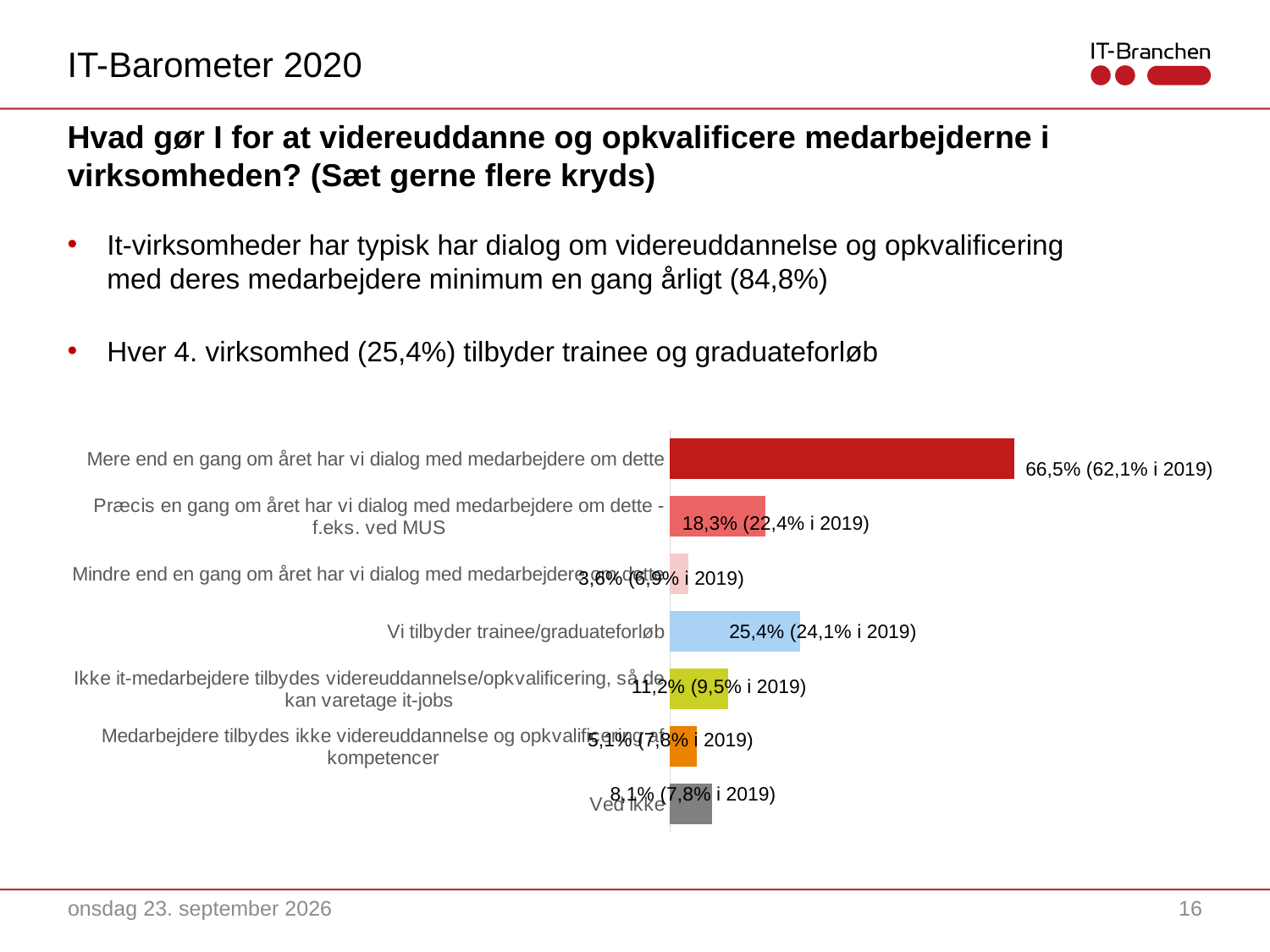
Which is larger: the value for "Vi tilbyder trainee/graduateforløb" or the value for "Præcis en gang om året har vi dialog med medarbejdere om dette - f.eks. ved MUS"? Vi tilbyder trainee/graduateforløb What colour is the bar for "Mere end en gang om året har vi dialog med medarbejdere om dette"? Red What is the difference between the values for "Mere end en gang om året har vi dialog med medarbejdere om dette" and "Præcis en gang om året har vi dialog med medarbejdere om dette - f.eks. ved MUS"? 48,2 percentage points What is the value for "Vi tilbyder trainee/graduateforløb"? 25,4% What was the 2019 value shown in the label for "Vi tilbyder trainee/graduateforløb"? 24,1% What is the value for "Præcis en gang om året har vi dialog med medarbejdere om dette - f.eks. ved MUS"? 18,3% Which category has the lowest value? Mindre end en gang om året har vi dialog med medarbejdere om dette How many categories are shown in the chart? 7 What is the value for "Ved ikke"? 8,1% What kind of chart is shown on the slide? Bar chart What is the value for "Mere end en gang om året har vi dialog med medarbejdere om dette"? 66,5% Which category has the highest value? Mere end en gang om året har vi dialog med medarbejdere om dette